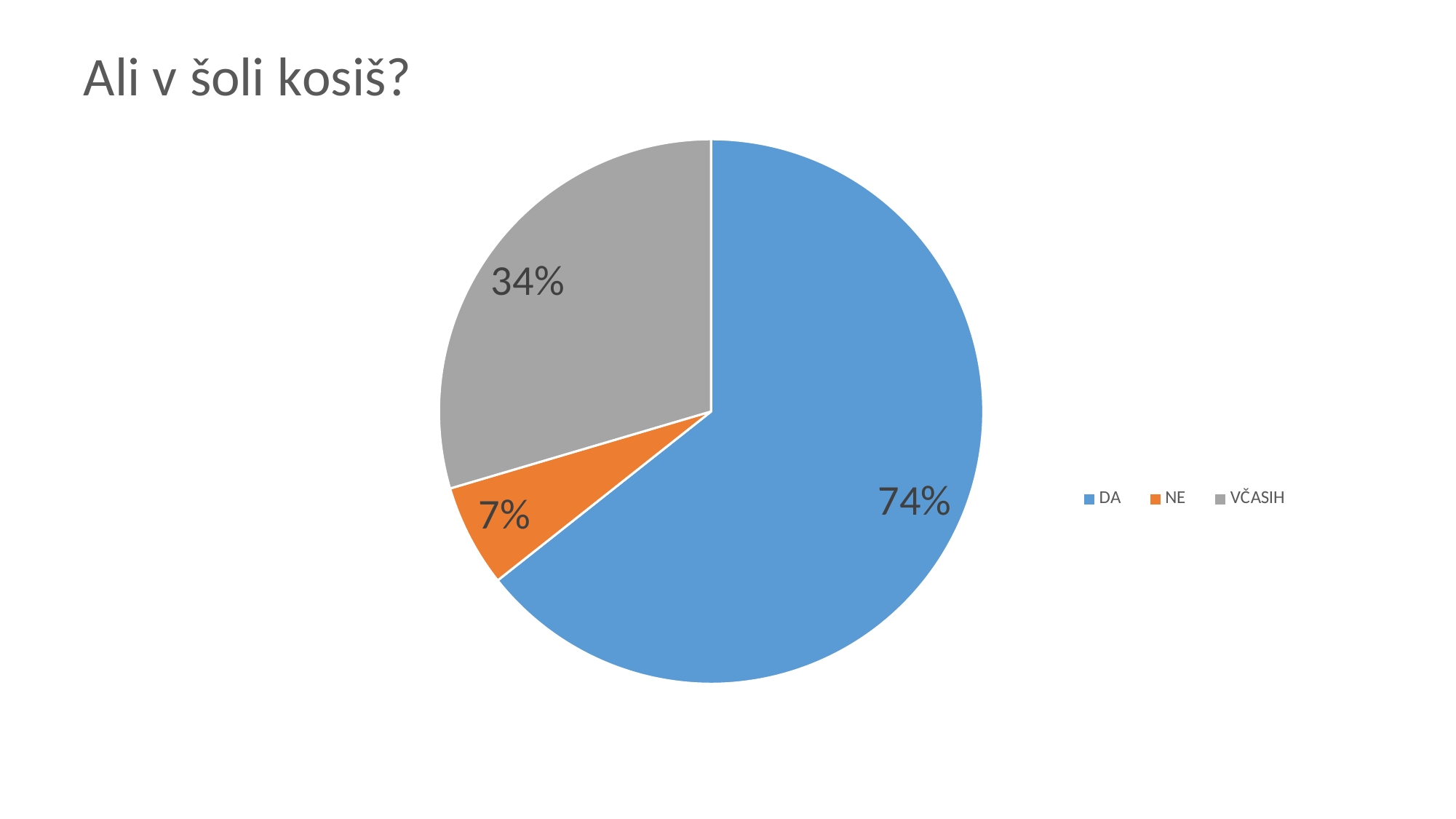
What is the title of the slide? Ali v šoli kosiš? What percentage of the pie is labelled NE? 7% Which category has the largest slice of the pie? DA Which category has the smallest slice of the pie? NE What colour is the DA slice in the pie chart? Blue What is the difference in percentage points between the DA slice and the VČASIH slice? 40 What is the difference in percentage points between the VČASIH slice and the NE slice? 27 Which slice is larger, NE or VČASIH? VČASIH What percentage of the pie is labelled VČASIH? 34% What kind of chart is shown on the slide? Pie chart How many slices does the pie chart have? 3 What percentage of the pie is labelled DA? 74%